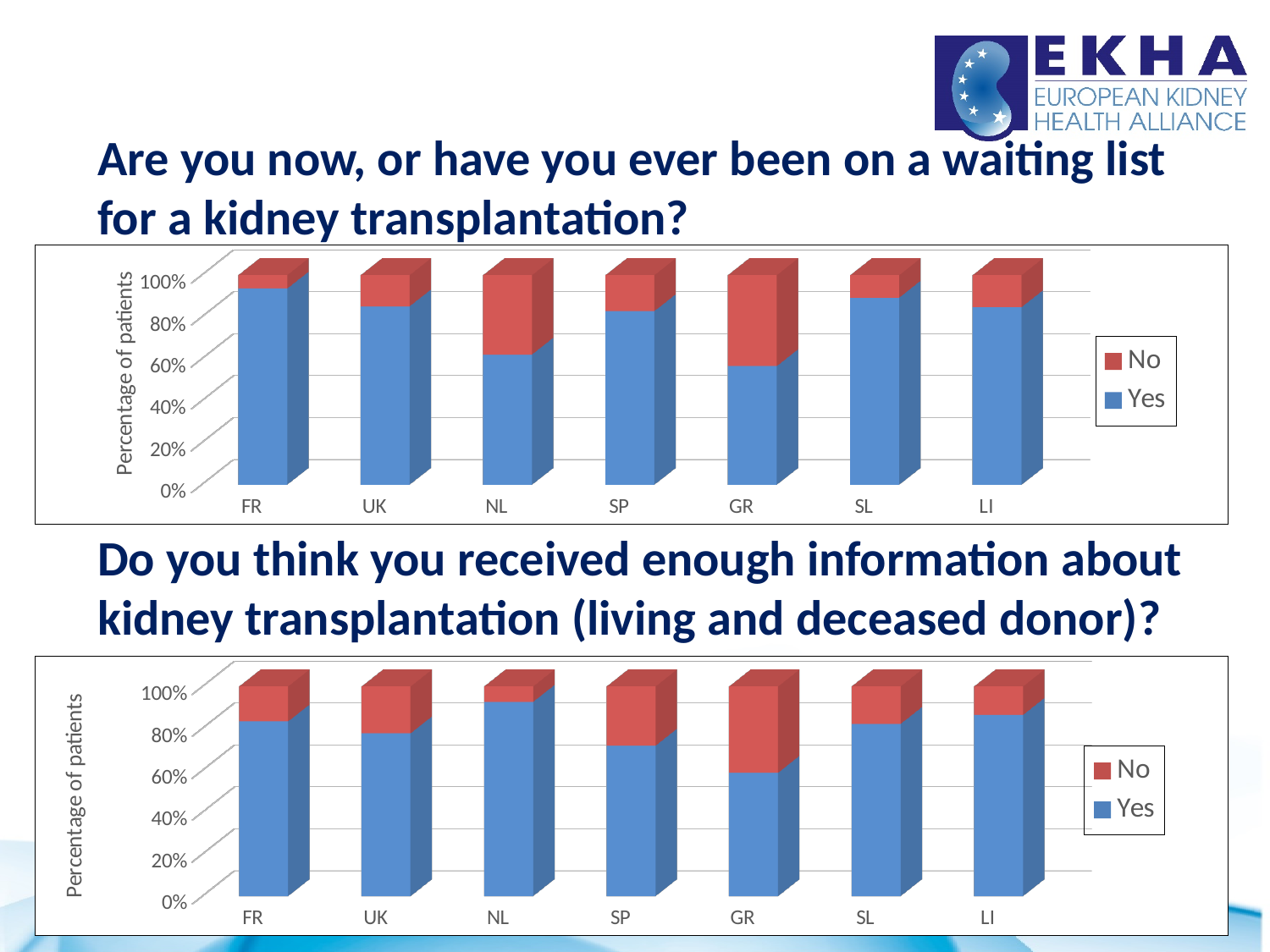
In the top chart, which has the larger 'Yes' share, NL or GR? NL How many series does the legend of the bottom chart list? 2 In the bottom chart, is the 'Yes' share for SP greater or less than 80%? less In the top chart, is the 'Yes' share for FR greater or less than 80%? greater In the top chart, is the 'Yes' share for GR greater or less than 40%? greater In the top chart (waiting list for a kidney transplantation), which country has the largest share of 'No' responses? GR In the bottom chart (enough information about kidney transplantation), which country has the lowest share of 'Yes' responses? GR In the bottom chart, which has the larger 'No' share, GR or FR? GR How many countries are shown on the x axis of the top chart? 7 In the top chart (waiting list for a kidney transplantation), which country has the lowest share of 'Yes' responses? GR In the bottom chart (enough information about kidney transplantation), which country has the highest share of 'Yes' responses? NL